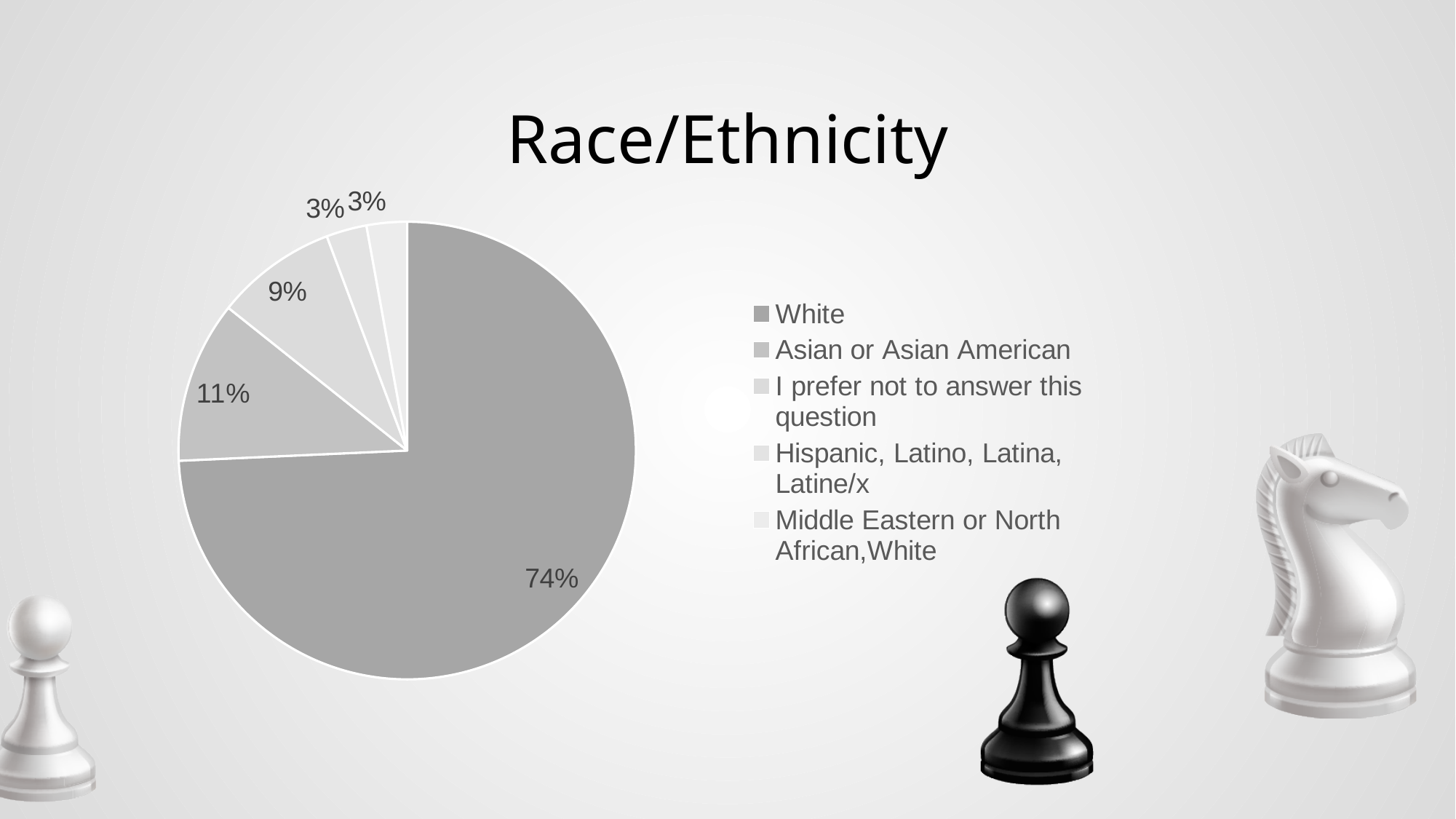
What share of the pie is Hispanic, Latino, Latina, Latine/x? 3% What share of the pie is Asian or Asian American? 11% Which is larger, the Asian or Asian American slice or the 'I prefer not to answer this question' slice? Asian or Asian American What is the difference in percentage points between the White slice and the Asian or Asian American slice? 63 What type of chart is shown on the slide? pie chart How many slices does the pie chart have? 5 What share of the pie is White? 74% How many categories does the legend list? 5 Which category has the largest slice of the pie? White What is the difference in percentage points between the Asian or Asian American slice and the Hispanic, Latino, Latina, Latine/x slice? 8 What is the title of the chart? Race/Ethnicity